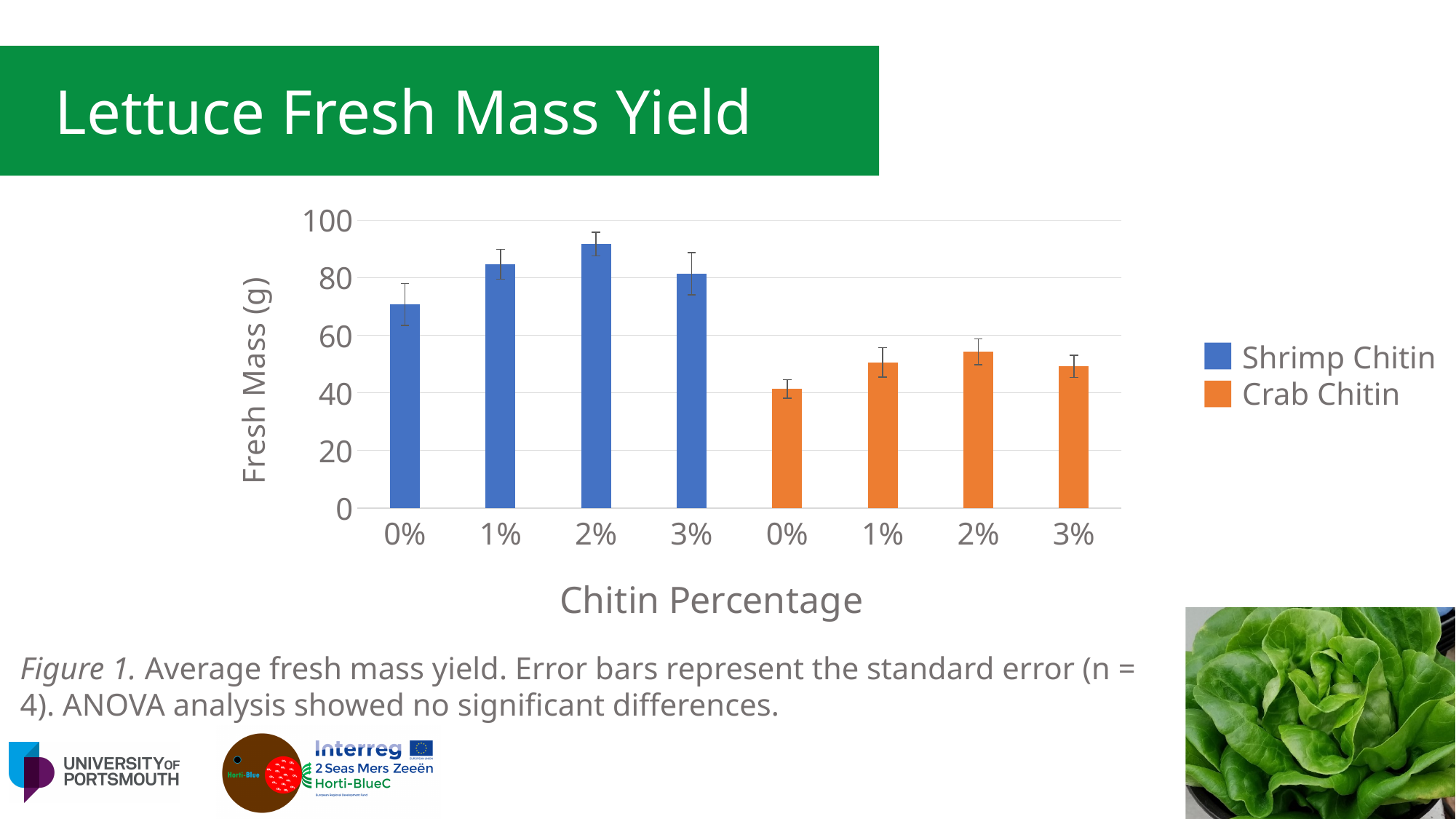
What kind of chart is shown on the slide? bar chart What is the label of the y axis? Fresh Mass (g) Which bar has the highest fresh mass in the chart? Shrimp Chitin 2% Is the fresh mass for Shrimp Chitin at 0% greater or less than 60? greater Is the fresh mass for Crab Chitin at 2% greater or less than 60? less Is the fresh mass for Crab Chitin at 1% greater or less than 40? greater Which is larger, the fresh mass for Shrimp Chitin at 0% or for Crab Chitin at 0%? Shrimp Chitin at 0% How many series does the legend list? 2 Which colour represents Crab Chitin in the legend? orange How many bars are plotted in the chart? 8 Which bar has the lowest fresh mass in the chart? Crab Chitin 0%